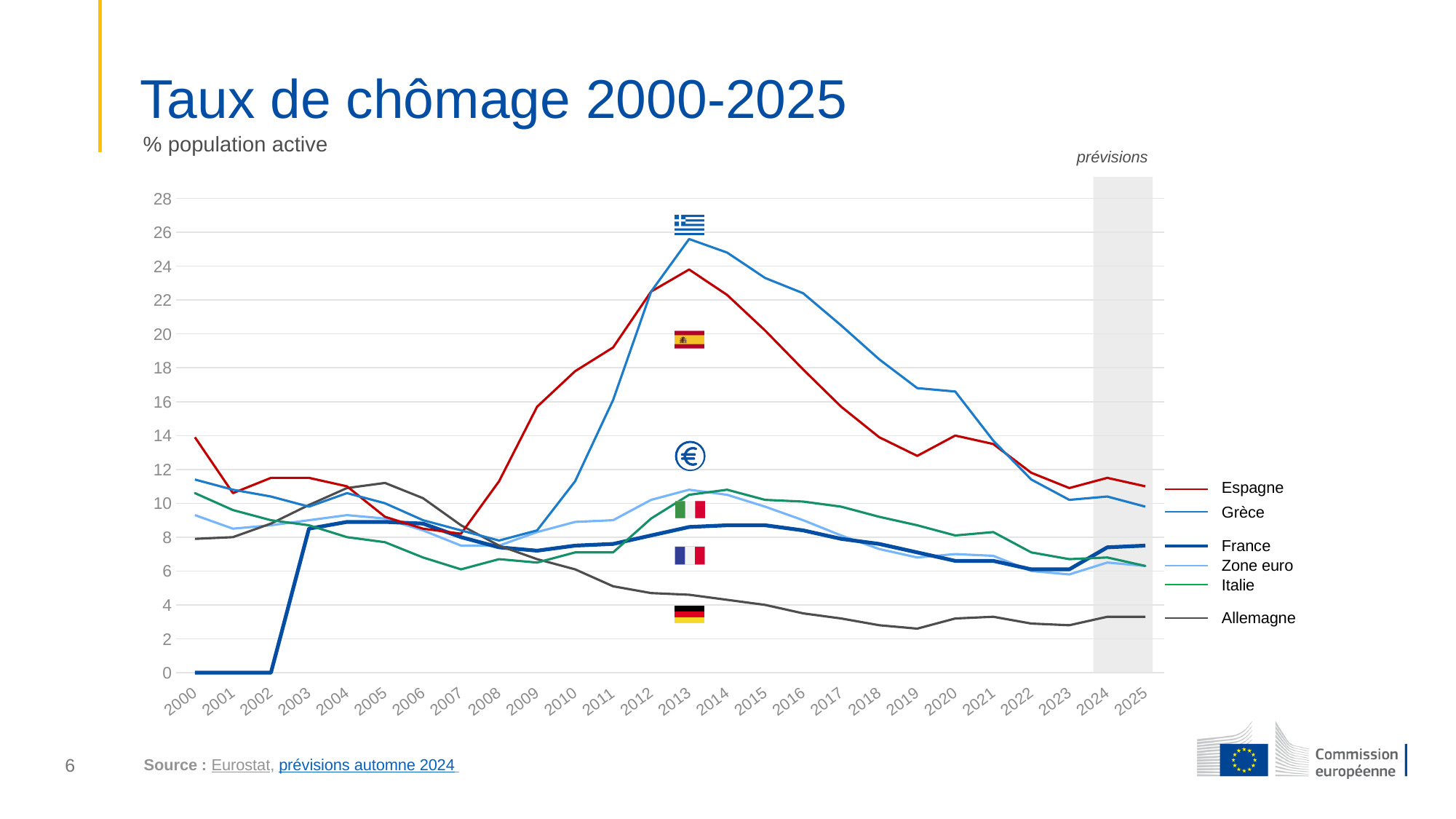
Is the value for Allemagne in 2019 greater or less than 4? less Which series has the highest value in 2000? Espagne How many series does the legend list? 6 Which series has the lowest value in 2025? Allemagne Which series reaches the highest value anywhere on the chart? Grèce Is the value for Grèce in 2013 greater or less than 24? greater What kind of chart is shown on the slide? line chart In 2005, which is larger: the value for Allemagne or the value for France? Allemagne What label is given to the shaded area covering 2024 and 2025? prévisions In 2019, which is larger: the value for Grèce or the value for Espagne? Grèce Does the value for Grèce rise or fall between 2013 and 2023? fall How many years are shown on the x axis? 26